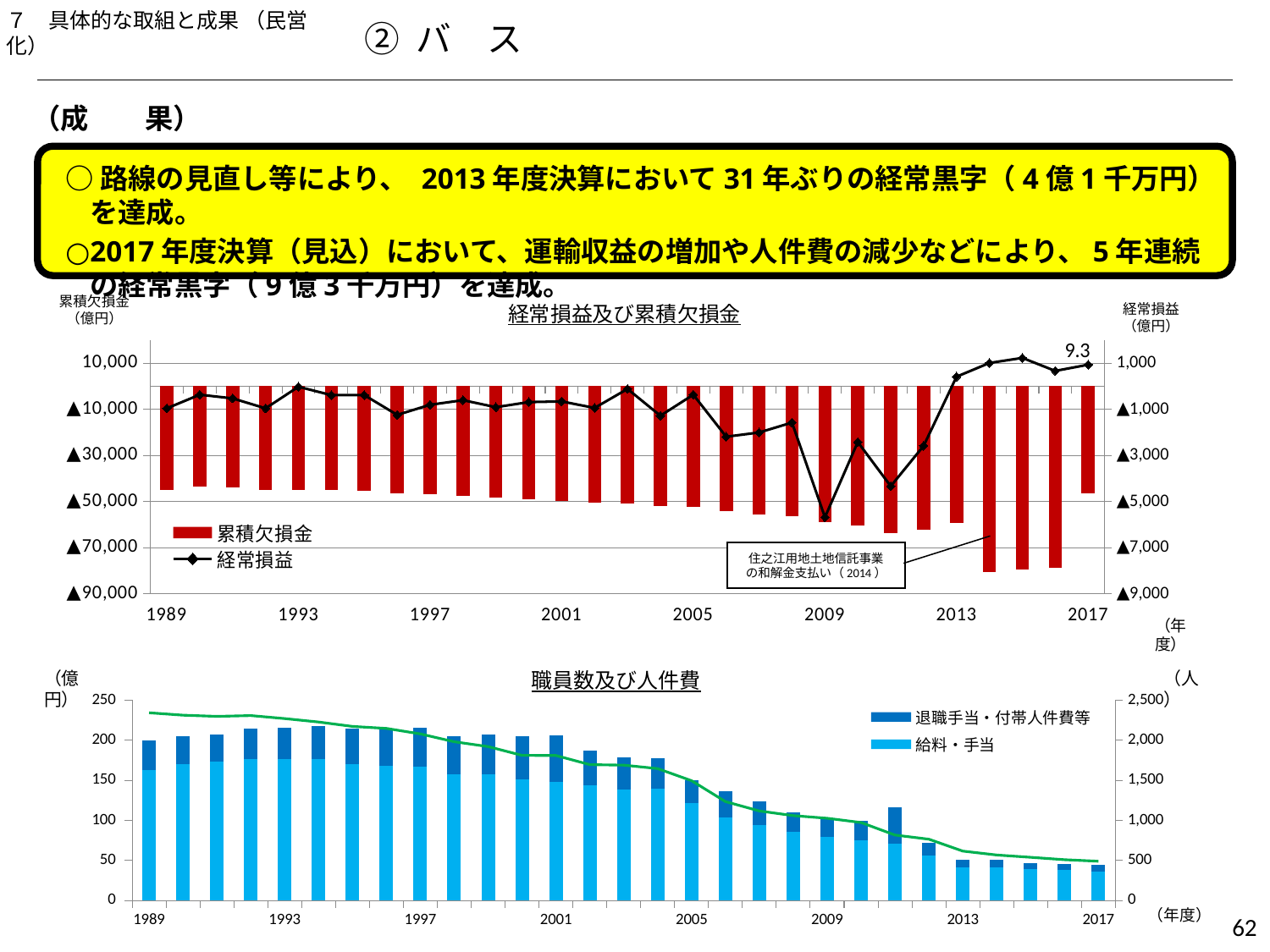
In the top chart 経常損益及び累積欠損金, is the 経常損益 value for 2009 greater or less than ▲5,000? less What kind of chart is the top chart 経常損益及び累積欠損金? Combined bar and line chart In the top chart 経常損益及び累積欠損金, which is larger, the 経常損益 value for 2013 or for 2009? 2013 In the bottom chart 職員数及び人件費, does the green line rise or fall from 1989 to 2017? fall In the top chart 経常損益及び累積欠損金, does the 経常損益 line rise or fall from 2011 to 2015? rise In the top chart 経常損益及び累積欠損金, is the 累積欠損金 value for 2014 greater or less than ▲70,000? less In the bottom chart 職員数及び人件費, is the total stacked bar for 2017 greater or less than 100? less What event does the annotation box in the top chart 経常損益及び累積欠損金 refer to? 住之江用地土地信託事業の和解金支払い（2014） In the top chart 経常損益及び累積欠損金, what is the labelled value of 経常損益 for 2017? 9.3 What kind of chart is the bottom chart 職員数及び人件費? Stacked bar chart with a line How many series does the legend of the bottom chart 職員数及び人件費 list? 2 How many series does the legend of the top chart 経常損益及び累積欠損金 list? 2